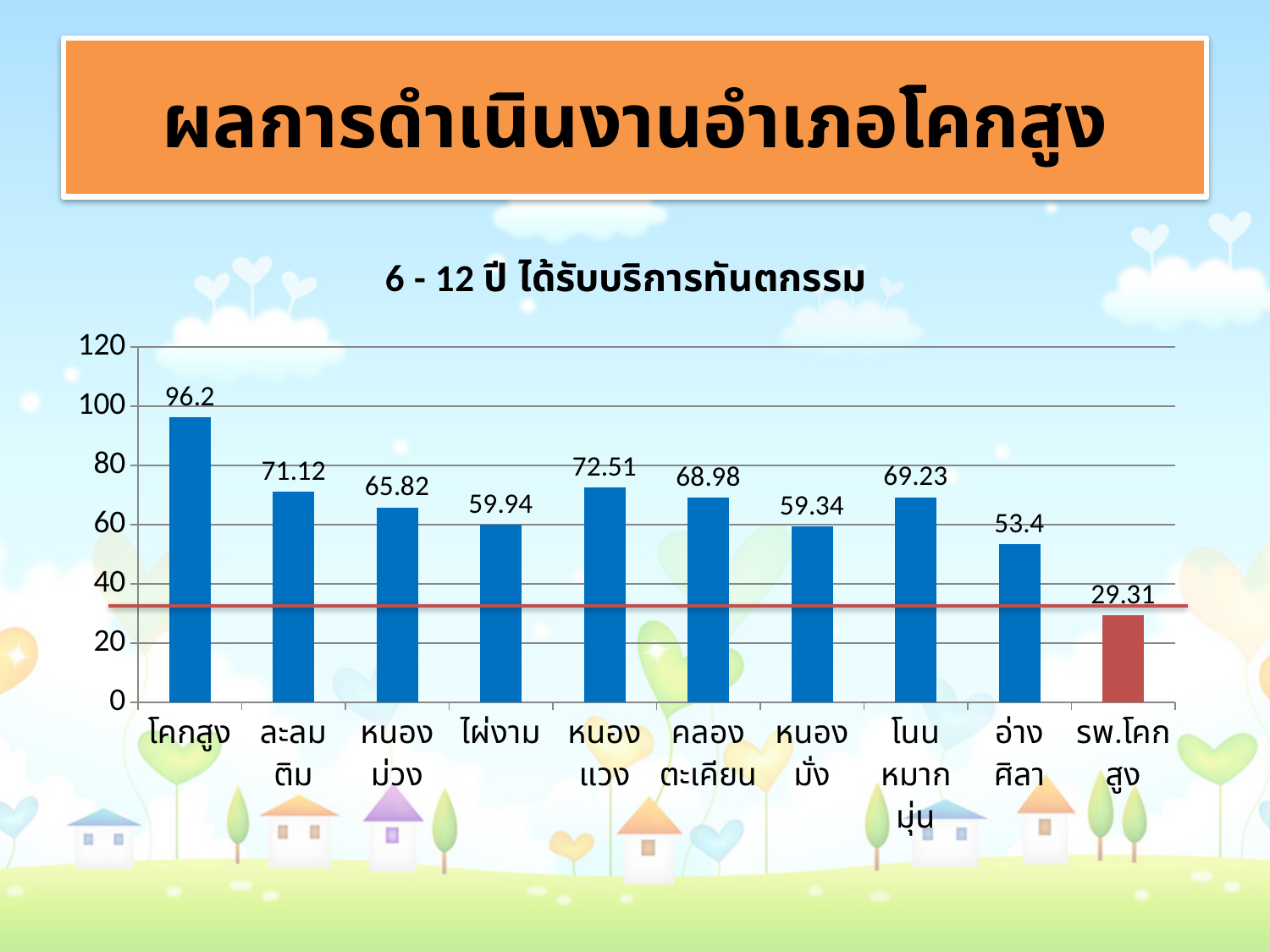
What is the value for อ่างศิลา? 53.4 Which category has the highest value? โคกสูง What kind of chart is shown on the slide? bar chart Which category has the lowest value? รพ.โคกสูง What is the difference between the values for โคกสูง and รพ.โคกสูง? 66.89 What is the value for โคกสูง? 96.2 Which is larger, the value for ละลมติม or the value for หนองม่วง? ละลมติม What is the title of the chart? 6 - 12 ปี ได้รับบริการทันตกรรม What is the value for หนองแวง? 72.51 What is the value for รพ.โคกสูง? 29.31 How many categories are shown on the x axis? 10 Is the value for คลองตะเคียน greater or less than 60? greater